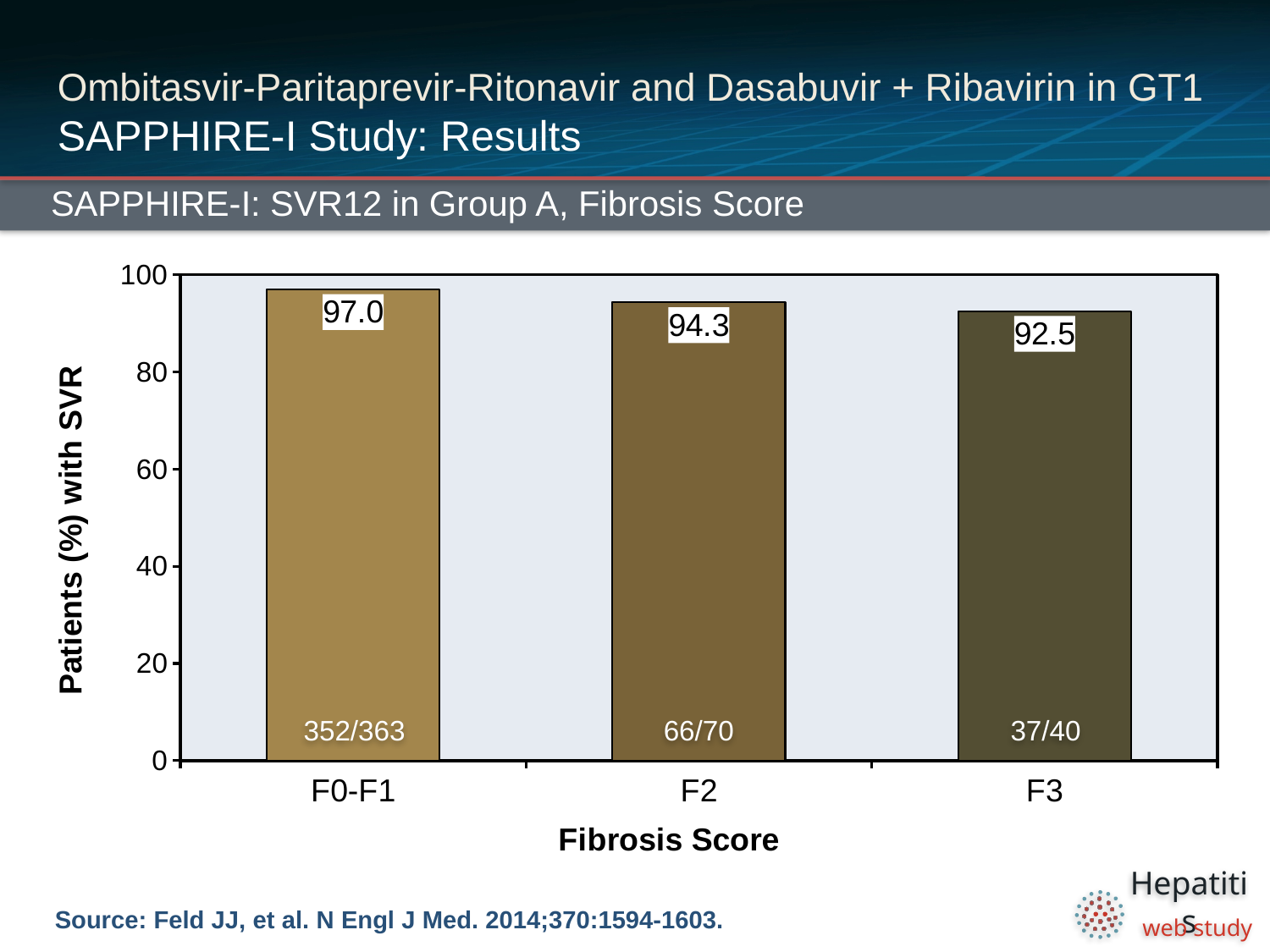
Which group has a higher SVR12 rate, F2 or F3? F2 What fraction is printed on the F3 bar? 37/40 Which fibrosis score group has the lowest SVR12 rate? F3 What type of chart is shown on the slide? Bar chart What is the difference in SVR12 rate between the F0-F1 and F3 groups? 4.5 How many patients achieved SVR out of the total in the F0-F1 group, as shown on the bar? 352/363 What is the SVR12 rate for patients with fibrosis score F0-F1? 97.0 What is the SVR12 rate for patients with fibrosis score F2? 94.3 How many fibrosis score categories are shown on the chart? 3 Which fibrosis score group has the highest SVR12 rate? F0-F1 Do the SVR12 rates rise or fall as the fibrosis score increases from F0-F1 to F3? Fall What is the SVR12 rate for patients with fibrosis score F3? 92.5